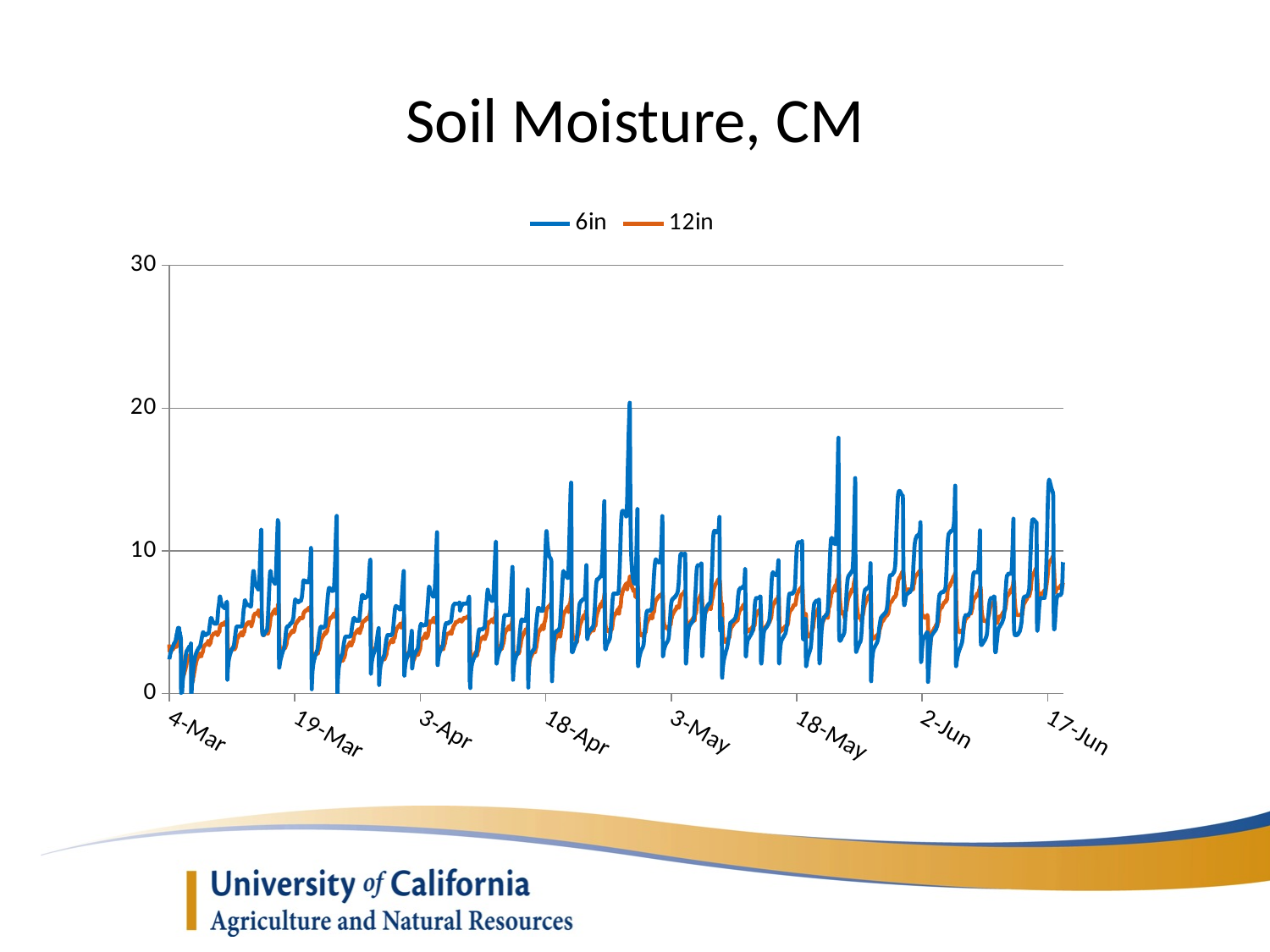
Is the highest value of the 6in series greater or less than 10? greater Is the highest value of the 6in series greater or less than 30? less What is the last date label on the x axis? 17-Jun Which series reaches the higher peak values, 6in or 12in? 6in Does the 12in series generally rise or fall from 4-Mar to 17-Jun? rise Is the highest value of the 12in series greater or less than 10? less What is the title of the chart? Soil Moisture, CM What kind of chart is shown on the slide? Line chart How many series does the legend list? 2 How many date labels are shown on the x axis? 8 What are the two series named in the legend? 6in and 12in What is the first date label on the x axis? 4-Mar